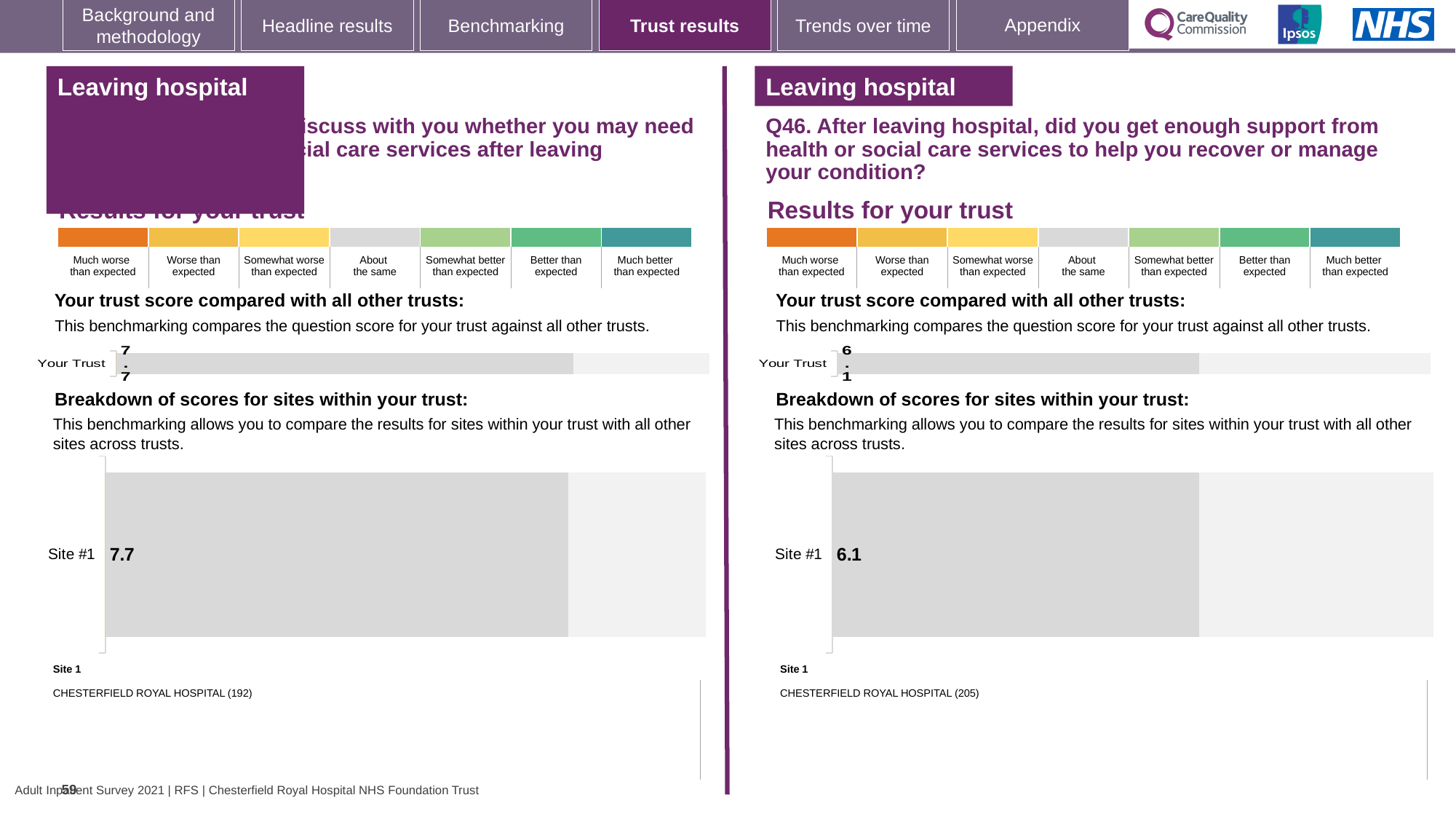
How many sites are shown in the right-hand 'Breakdown of scores for sites within your trust' chart (Q46)? 1 What is the difference between the Site #1 score in the left-hand breakdown chart and the Site #1 score in the right-hand breakdown chart (Q46)? 1.6 What kind of chart is used to show the Site #1 score in the right-hand breakdown chart (Q46)? Bar chart Is the Your Trust score on the right-hand side of the slide (Q46) the same as the Site #1 score in the right-hand breakdown chart? Yes, both are 6.1 On the left-hand side of the slide, what is the score shown for Your Trust? 7.7 Which hospital is listed as Site 1 below the right-hand breakdown chart (Q46)? CHESTERFIELD ROYAL HOSPITAL (205) In the left-hand 'Breakdown of scores for sites within your trust' chart, what is the score for Site #1? 7.7 Which is larger: the Your Trust score on the left-hand side of the slide or the Your Trust score on the right-hand side (Q46)? Left-hand side (7.7) How many sites are shown in the left-hand 'Breakdown of scores for sites within your trust' chart? 1 On the right-hand side of the slide (Q46), what is the score shown for Your Trust? 6.1 In the right-hand 'Breakdown of scores for sites within your trust' chart (Q46), what is the score for Site #1? 6.1 What is the question number shown above the right-hand 'Results for your trust' section? Q46